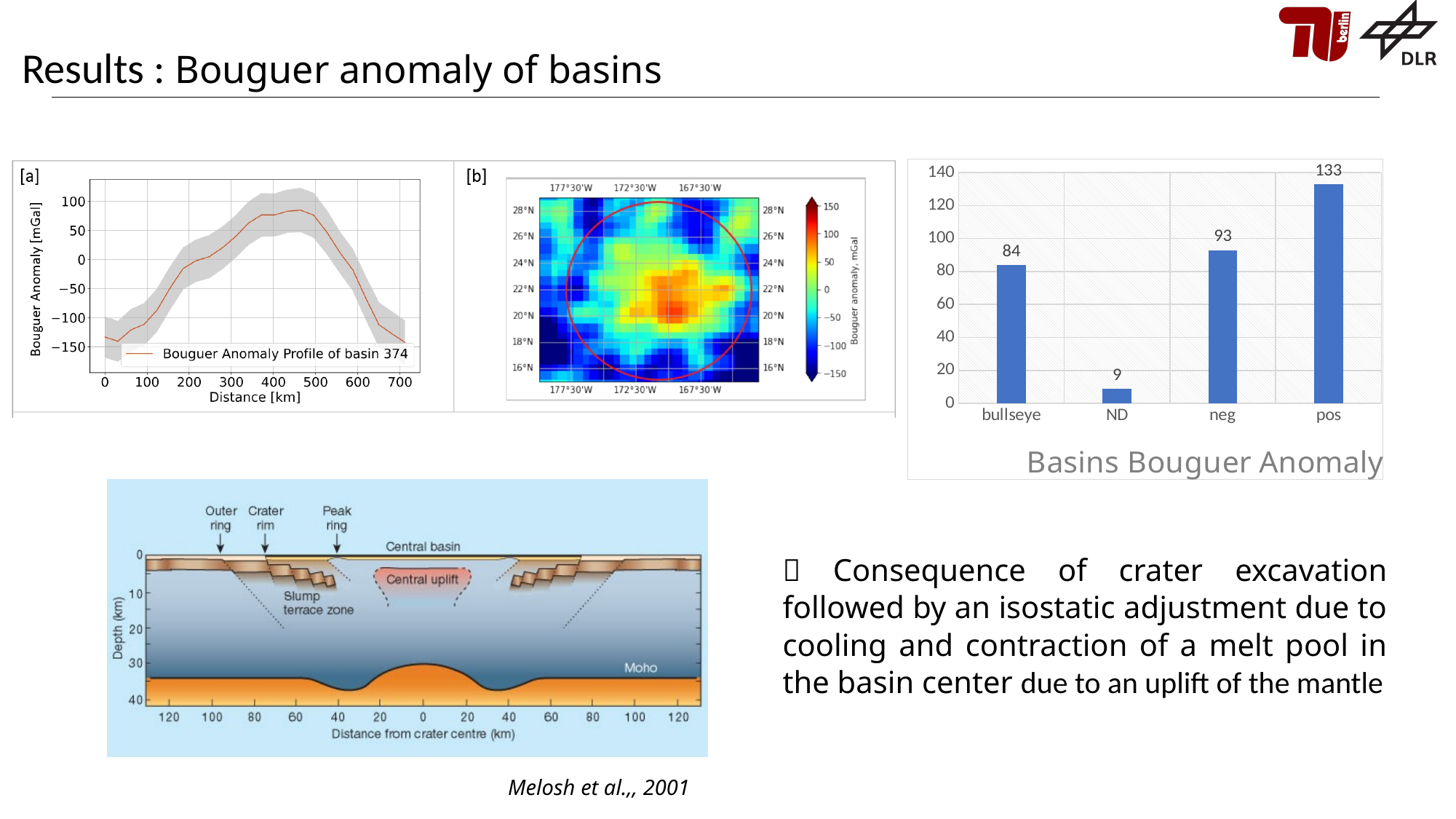
In the 'Basins Bouguer Anomaly' bar chart, which is larger, the value for neg or the value for bullseye? neg In the 'Basins Bouguer Anomaly' bar chart, what is the value for ND? 9 In the 'Basins Bouguer Anomaly' bar chart, what is the difference between the values for pos and neg? 40 In the 'Basins Bouguer Anomaly' bar chart, what is the value for pos? 133 In the 'Basins Bouguer Anomaly' bar chart, which category has the highest value? pos What kind of chart is the 'Basins Bouguer Anomaly' chart on the right of the slide? bar chart In the 'Basins Bouguer Anomaly' bar chart, what is the value for bullseye? 84 In the 'Basins Bouguer Anomaly' bar chart, what is the difference between the values for bullseye and ND? 75 In the 'Basins Bouguer Anomaly' bar chart, what is the value for neg? 93 In the 'Basins Bouguer Anomaly' bar chart, is the value for pos greater or less than 120? greater In the 'Basins Bouguer Anomaly' bar chart, which category has the lowest value? ND How many categories are shown in the 'Basins Bouguer Anomaly' bar chart? 4